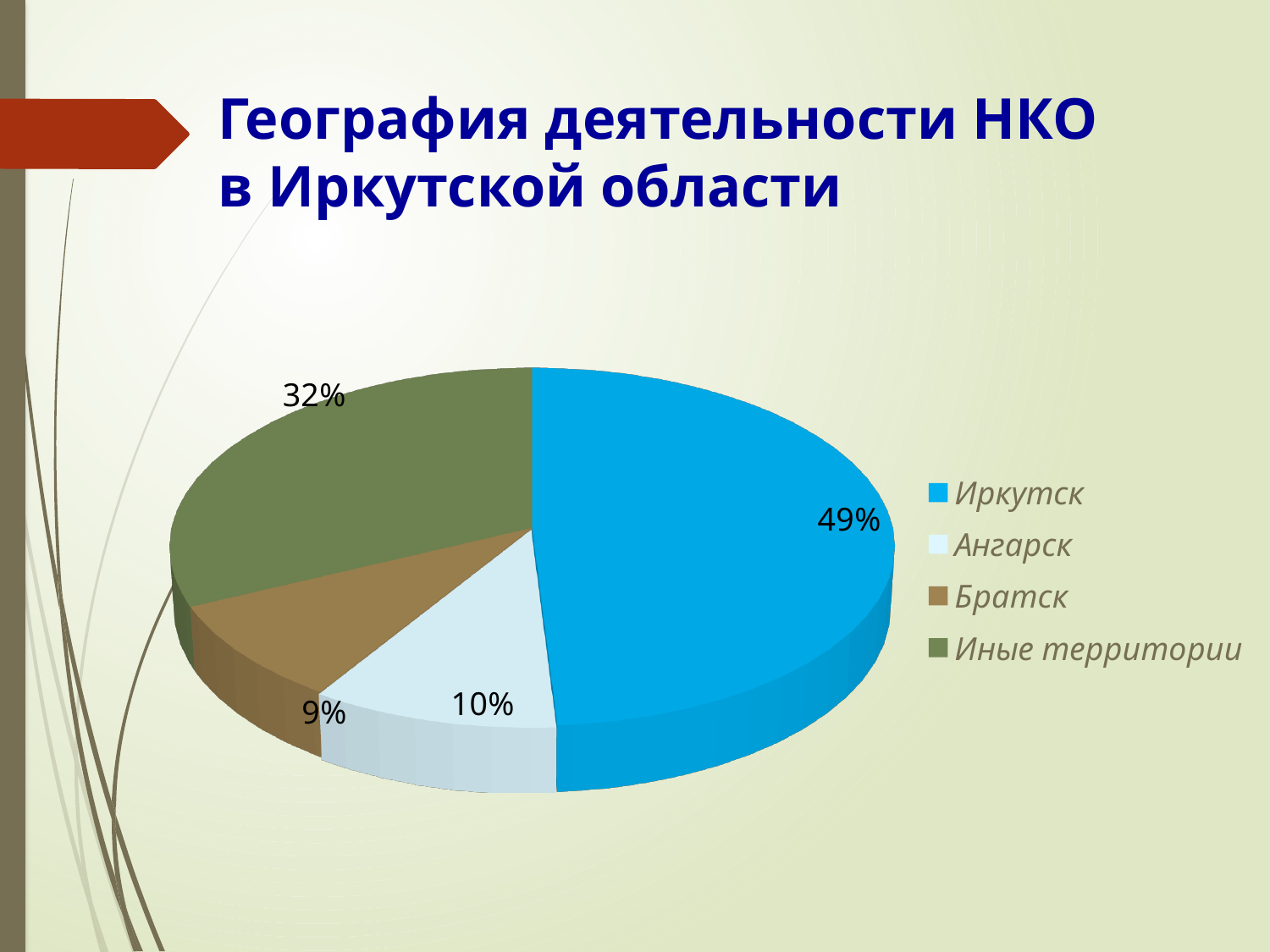
How many categories does the pie chart show? 4 What share of the pie does Иные территории have? 32% What kind of chart is shown on the slide? pie chart What is the title of the slide containing the chart? География деятельности НКО в Иркутской области What share of the pie does Иркутск have? 49% Which is larger, the share for Ангарск or the share for Иные территории? Иные территории Which category has the smallest slice of the pie? Братск What is the difference in percentage points between Иркутск and Иные территории? 17 What share of the pie does Ангарск have? 10% What share of the pie does Братск have? 9% Which category has the largest slice of the pie? Иркутск What colour is the slice for Иркутск? blue